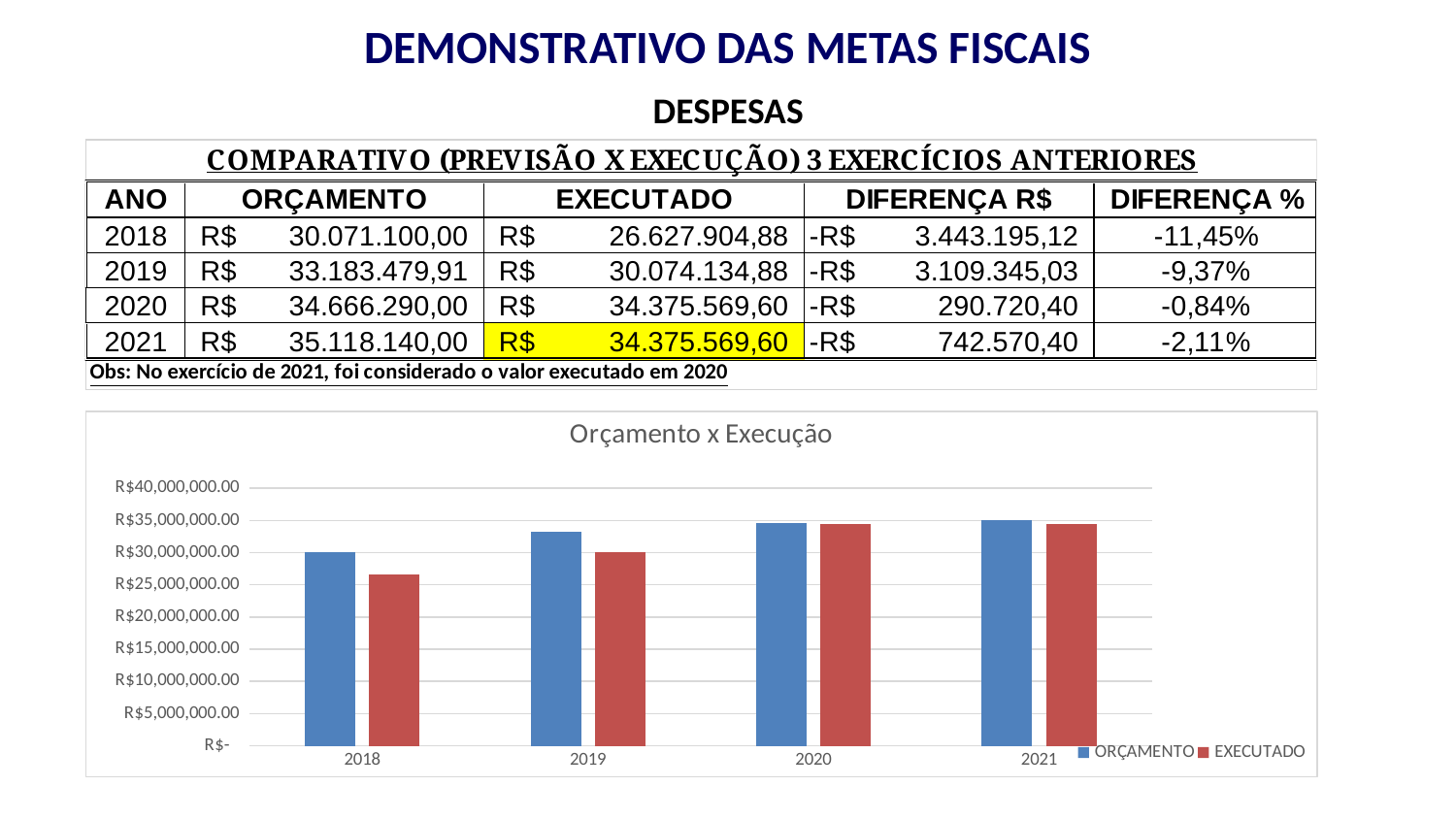
Which colour represents ORÇAMENTO in the chart? blue According to the table on the slide, what is the ORÇAMENTO value for 2019? R$ 33.183.479,91 Which year has the lowest EXECUTADO value in the chart? 2018 How many years are shown on the x axis of the chart? 4 Is the ORÇAMENTO value for 2018 greater or less than R$25,000,000.00? greater What kind of chart is shown on the slide? bar chart Do the ORÇAMENTO values rise or fall from 2018 to 2021? rise Is the ORÇAMENTO value for 2021 greater or less than R$30,000,000.00? greater How many series does the chart legend list? 2 Is the EXECUTADO value for 2018 greater or less than R$30,000,000.00? less What is the title of the chart? Orçamento x Execução In 2018, which is larger, ORÇAMENTO or EXECUTADO? ORÇAMENTO